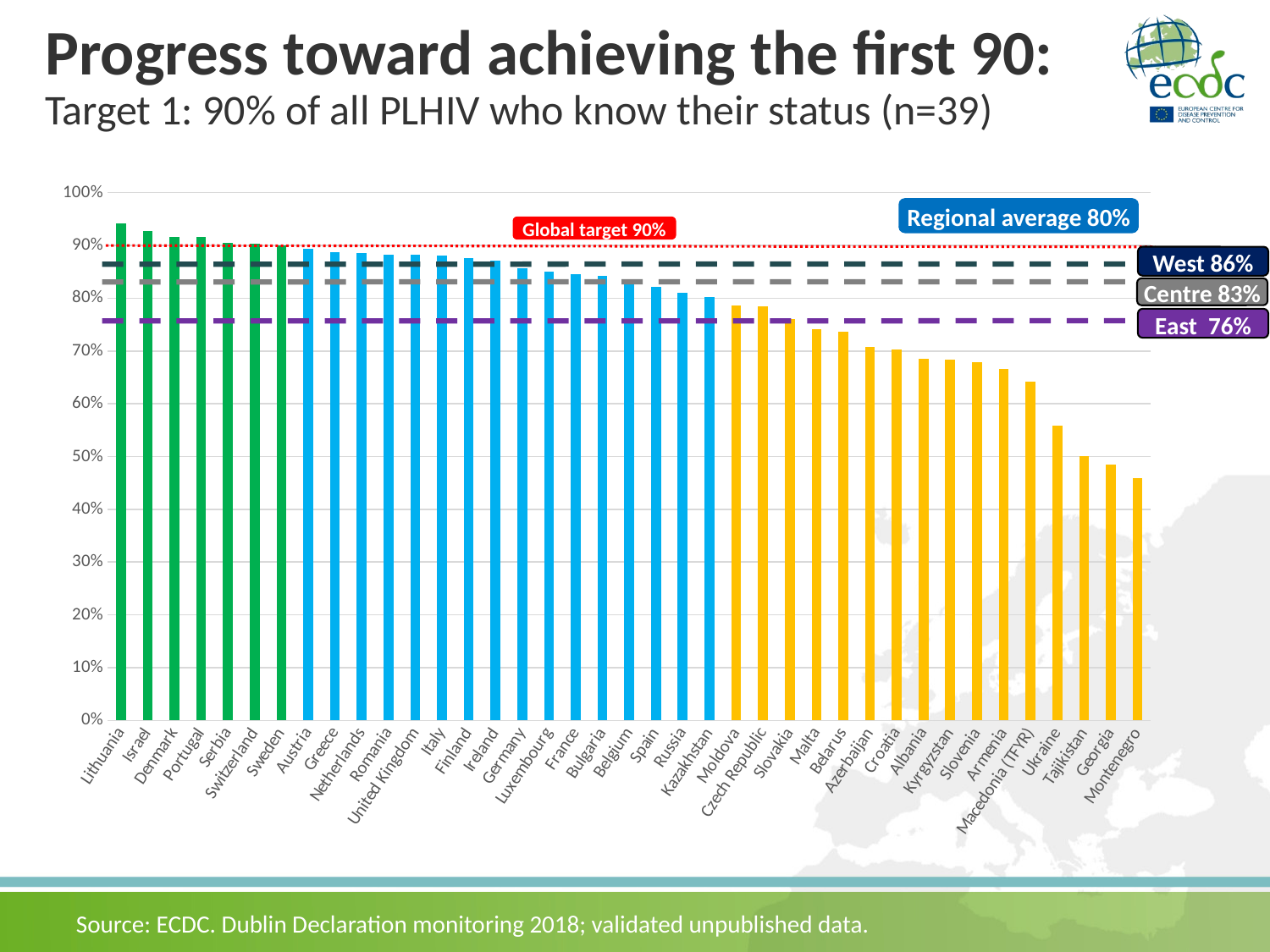
What is the global target value shown on the chart? 90% Is the value for Moldova greater or less than 80%? less Which country has the highest bar in the chart? Lithuania What value is shown for the West sub-region line? 86% Which country has the lowest bar in the chart? Montenegro What is the regional average shown on the chart? 80% Is the value for Montenegro greater or less than 50%? less Which country has a higher value, Israel or Ukraine? Israel How many countries are plotted in the chart? 39 Is the value for Lithuania greater or less than 90%? greater What kind of chart is shown on the slide? bar chart What value is shown for the East sub-region line? 76%